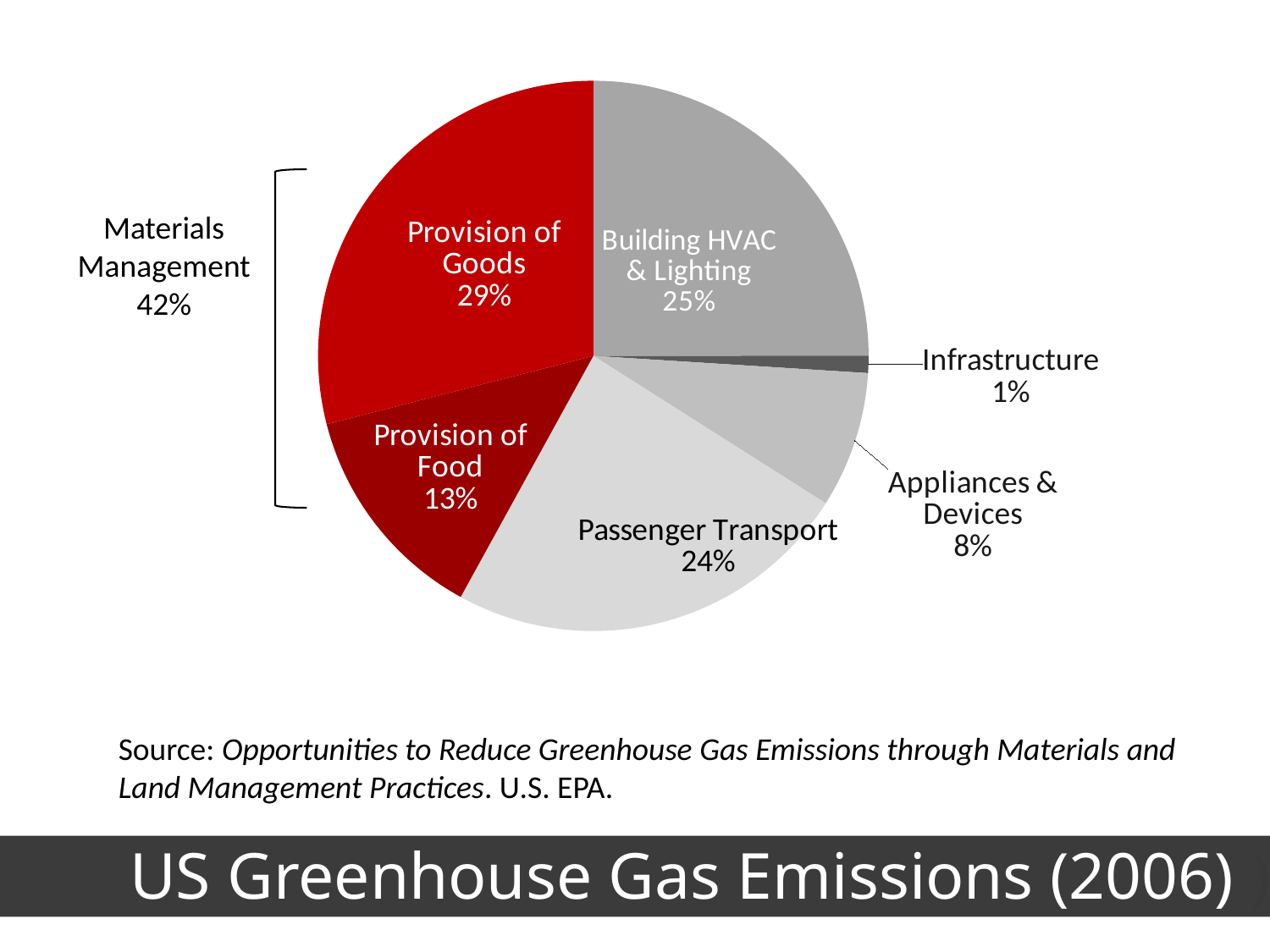
What percentage is shown for Infrastructure? 1% What combined percentage is labelled for Materials Management? 42% Which slice of the pie is the largest? Provision of Goods What share of US greenhouse gas emissions does Provision of Goods account for? 29% Which slice of the pie is the smallest? Infrastructure What percentage is shown for Passenger Transport? 24% Which is larger, Appliances & Devices or Provision of Food? Provision of Food What percentage is shown for Building HVAC & Lighting? 25% What kind of chart is shown on the slide? Pie chart What is the title shown at the bottom of the slide? US Greenhouse Gas Emissions (2006) How many slices does the pie chart have? 6 What is the difference in percentage points between Provision of Goods and Provision of Food? 16